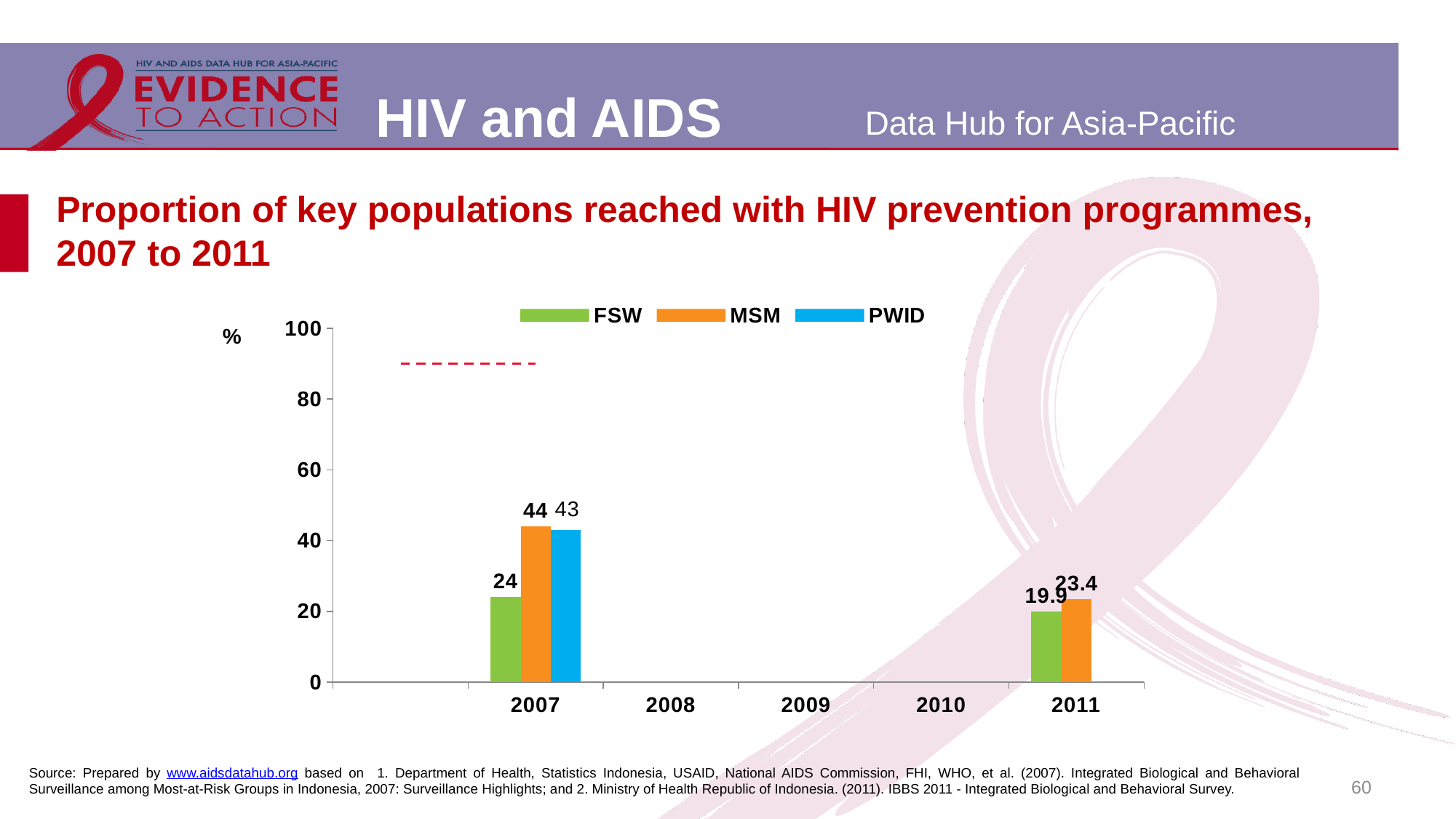
What is the difference between the MSM and FSW values in 2007? 20 How many series does the legend list? 3 What is the value for FSW in 2011? 19.9 Which series has the highest value in 2007? MSM Is the FSW value larger in 2007 or in 2011? 2007 What kind of chart is shown on the slide? Bar chart What is the value for MSM in 2007? 44 Which colour represents PWID in the chart? Blue What is the value for FSW in 2007? 24 What is the value for PWID in 2007? 43 What is the value for MSM in 2011? 23.4 Which series has the lowest value in 2007? FSW